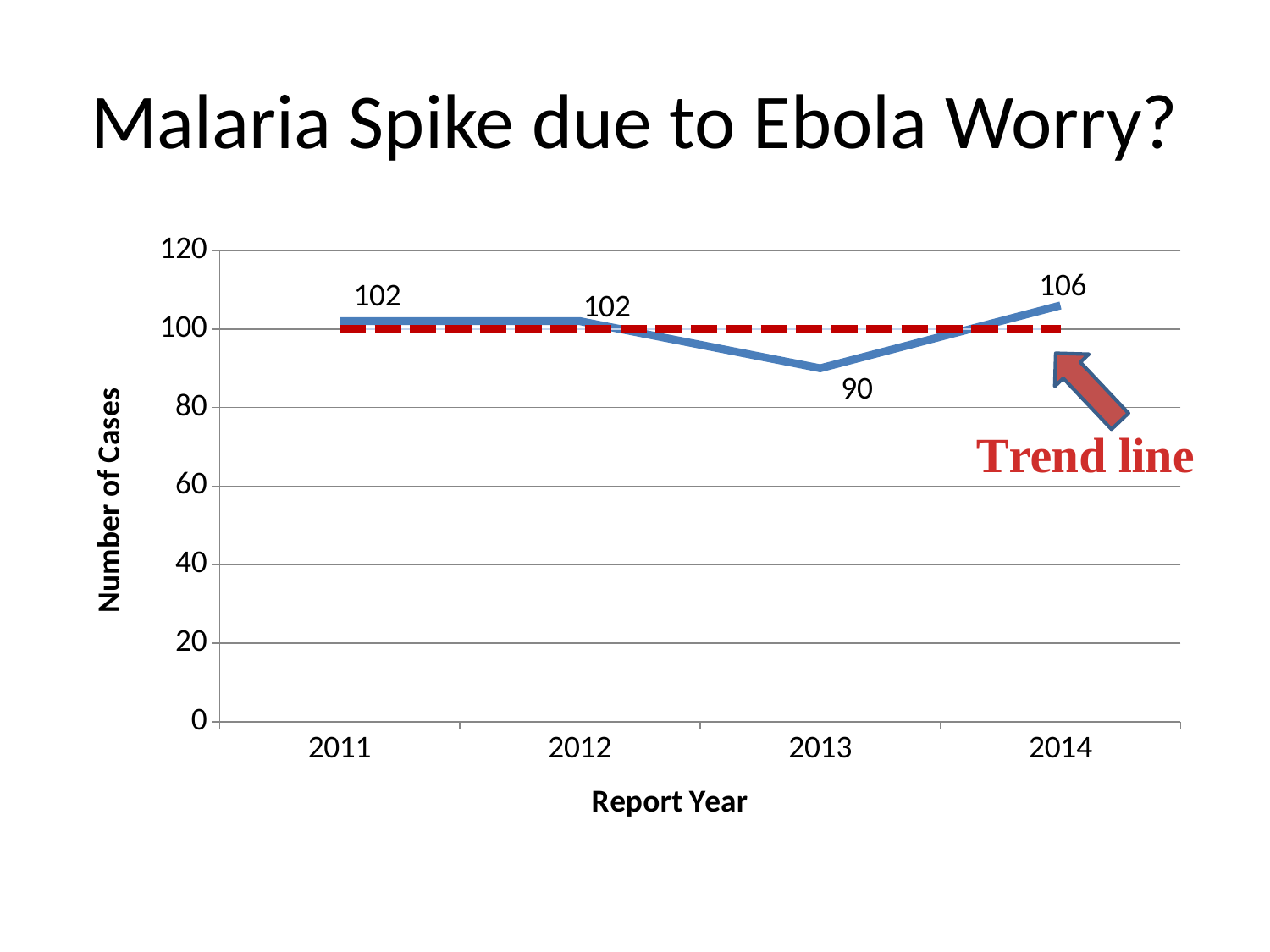
What is the number of cases in 2014? 106 Which report year has the lowest number of cases? 2013 Is the value for 2013 greater or less than 100? less How many report years are plotted on the chart? 4 Do the number of cases rise or fall from 2013 to 2014? rise Which report year has the highest number of cases? 2014 What is the number of cases in 2011? 102 What kind of chart is shown on the slide? line chart What is the number of cases in 2013? 90 What is the difference in number of cases between 2014 and 2013? 16 Which year has more cases, 2012 or 2013? 2012 What is the label of the y axis? Number of Cases